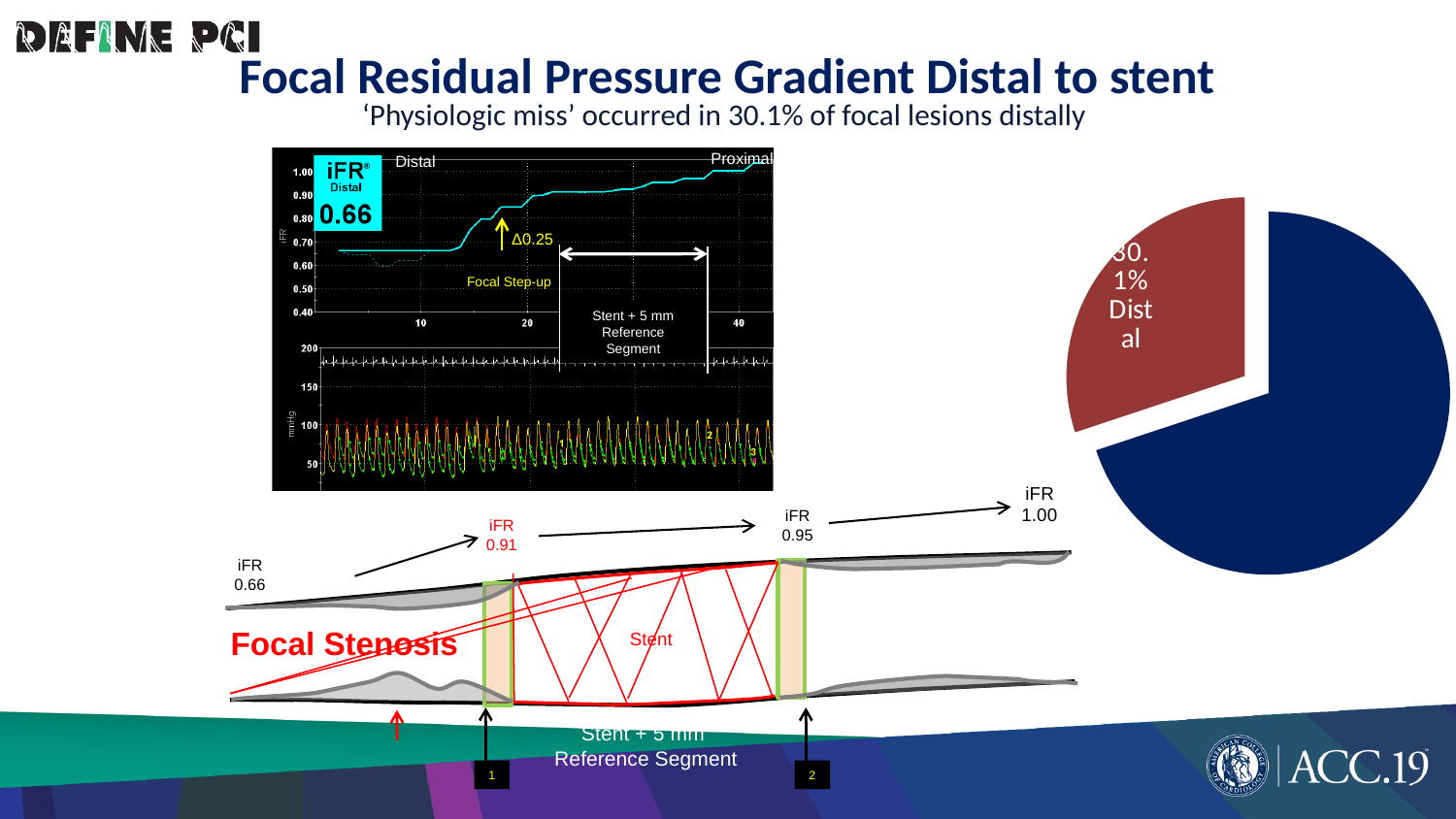
In the pie chart, is the share of the 'Distal' slice greater or less than 50%? less What kind of chart is shown on the right side of the slide? pie chart In the pie chart, what share is shown for the 'Distal' slice? 30.1% In the vessel schematic at the bottom, what iFR value is shown at the proximal end (far right)? 1.00 How many slices does the pie chart have? 2 In the iFR pullback trace, what is the size of the focal step-up marked with the yellow arrow? Δ0.25 In the pie chart, which slice is larger, the red 'Distal' slice or the dark blue slice? the dark blue slice In the pie chart, what colour is the slice labelled '30.1% Distal'? red In the iFR pullback trace, does the iFR value rise or fall moving from the distal end to the proximal end along the x axis? rise In the vessel schematic at the bottom, what iFR value is shown just distal to the stent (labelled in red)? 0.91 In the pie chart, what is the label on the red slice? 30.1% Distal In the iFR pullback trace at the top left, what distal iFR value is displayed in the box? 0.66